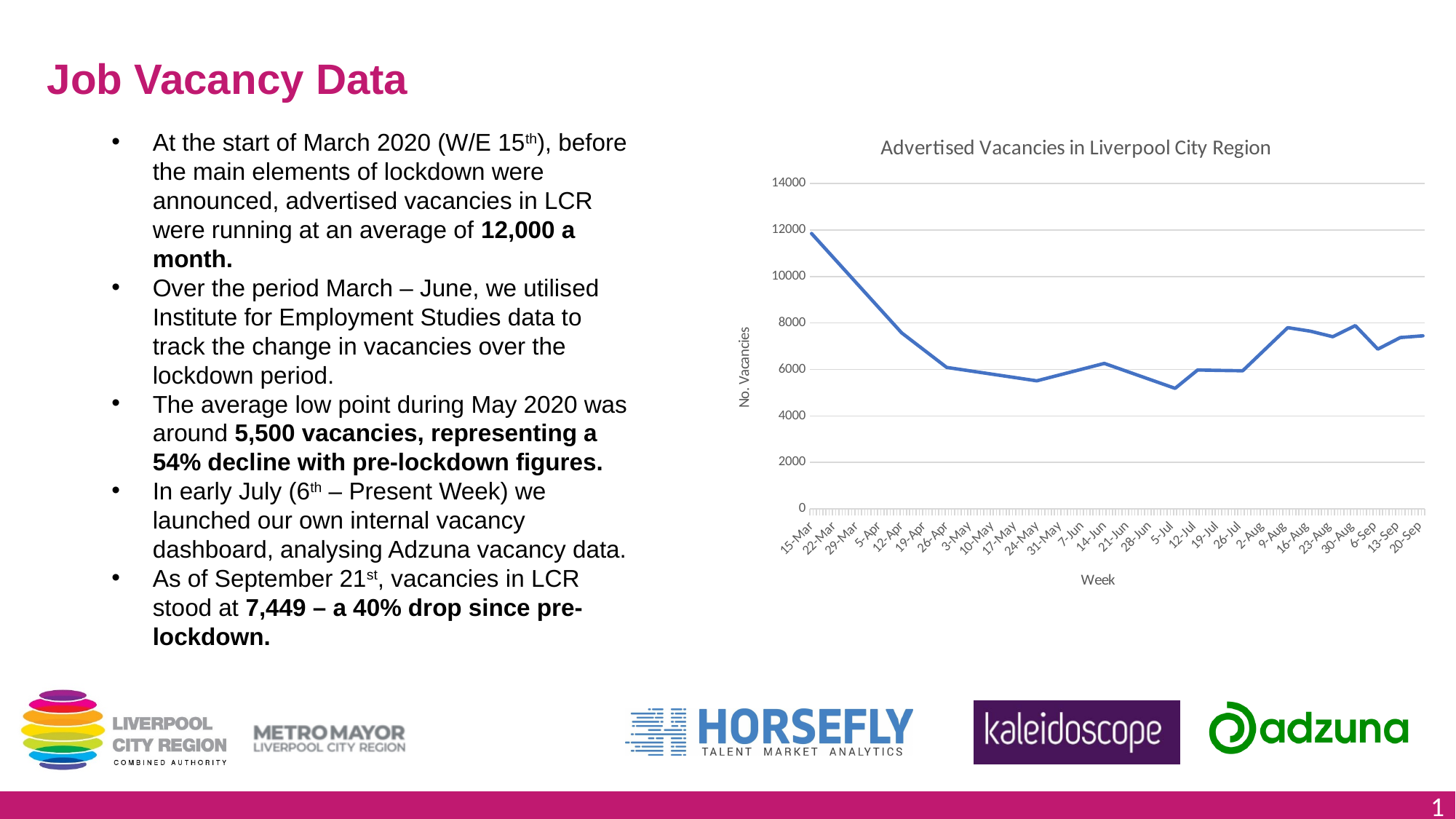
Is the value for 20-Sep greater or less than 8000? less Which week has the larger number of vacancies, 15-Mar or 20-Sep? 15-Mar Is the value for 15-Mar greater or less than 10000? greater Which week has the larger number of vacancies, 5-Jul or 9-Aug? 9-Aug Is the value for 5-Jul greater or less than 6000? less What is the title of the chart? Advertised Vacancies in Liverpool City Region Which week has the highest number of advertised vacancies in the chart? 15-Mar What kind of chart is shown on the slide? line chart Do advertised vacancies rise or fall between 15-Mar and 26-Apr? fall What is the label on the vertical axis of the chart? No. Vacancies